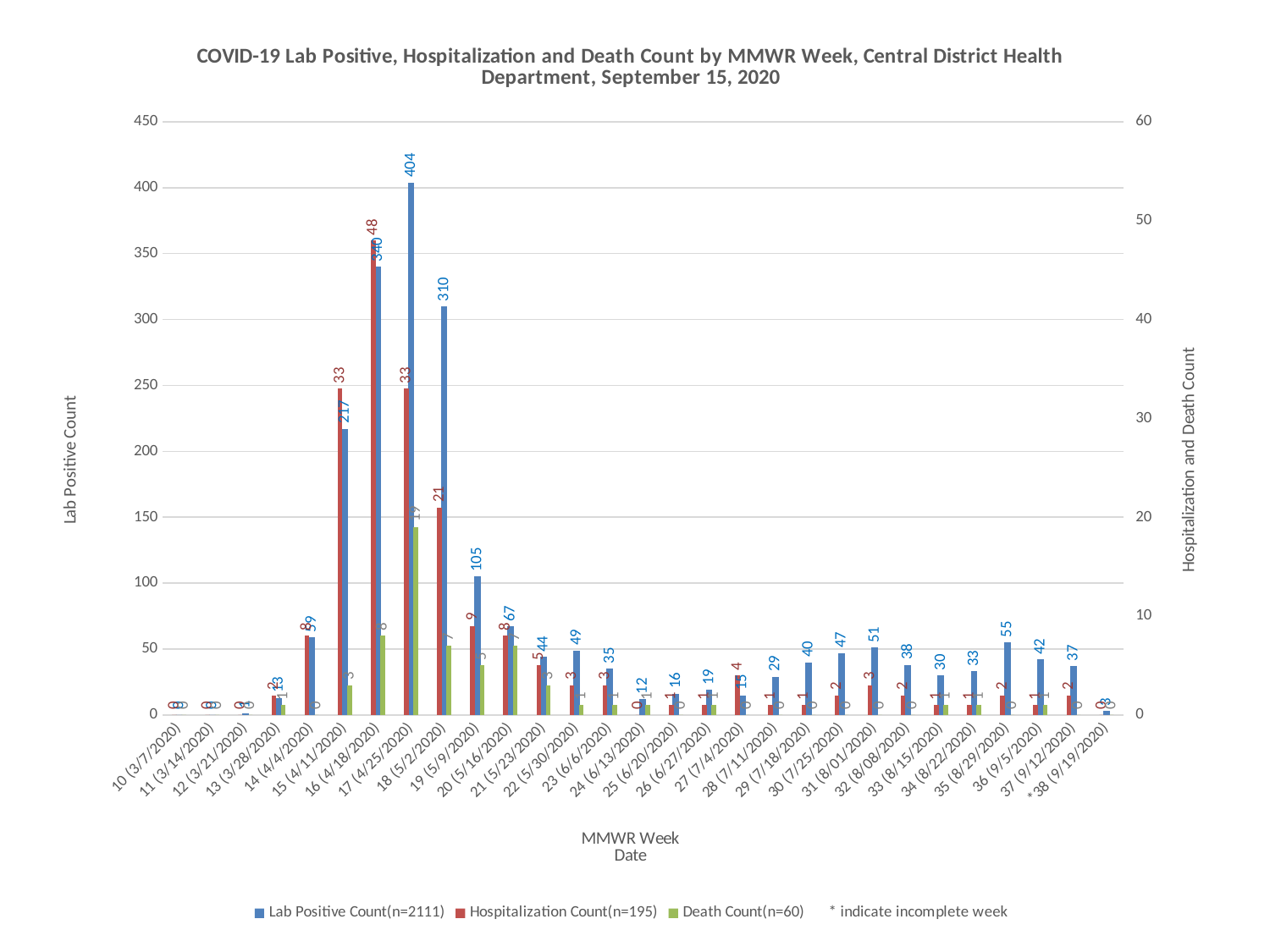
Is the Lab Positive Count for week 19 (5/9/2020) greater or less than 100? greater How many MMWR weeks are shown on the x axis? 29 What type of chart is shown on the slide? Bar chart How many series does the legend list? 3 What is the title of the right-hand vertical axis? Hospitalization and Death Count Which is larger, the Lab Positive Count for week 15 (4/11/2020) or week 16 (4/18/2020)? Week 16 (4/18/2020) What is the Lab Positive Count for MMWR week 18 (5/2/2020)? 310 What is the Hospitalization Count for MMWR week 16 (4/18/2020)? 48 What is the difference between the Lab Positive Count in week 17 (4/25/2020) and week 18 (5/2/2020)? 94 Which MMWR week has the highest Lab Positive Count? 17 (4/25/2020) What is the Lab Positive Count for MMWR week 17 (4/25/2020)? 404 Does the Lab Positive Count rise or fall from week 17 (4/25/2020) to week 24 (6/13/2020)? Fall